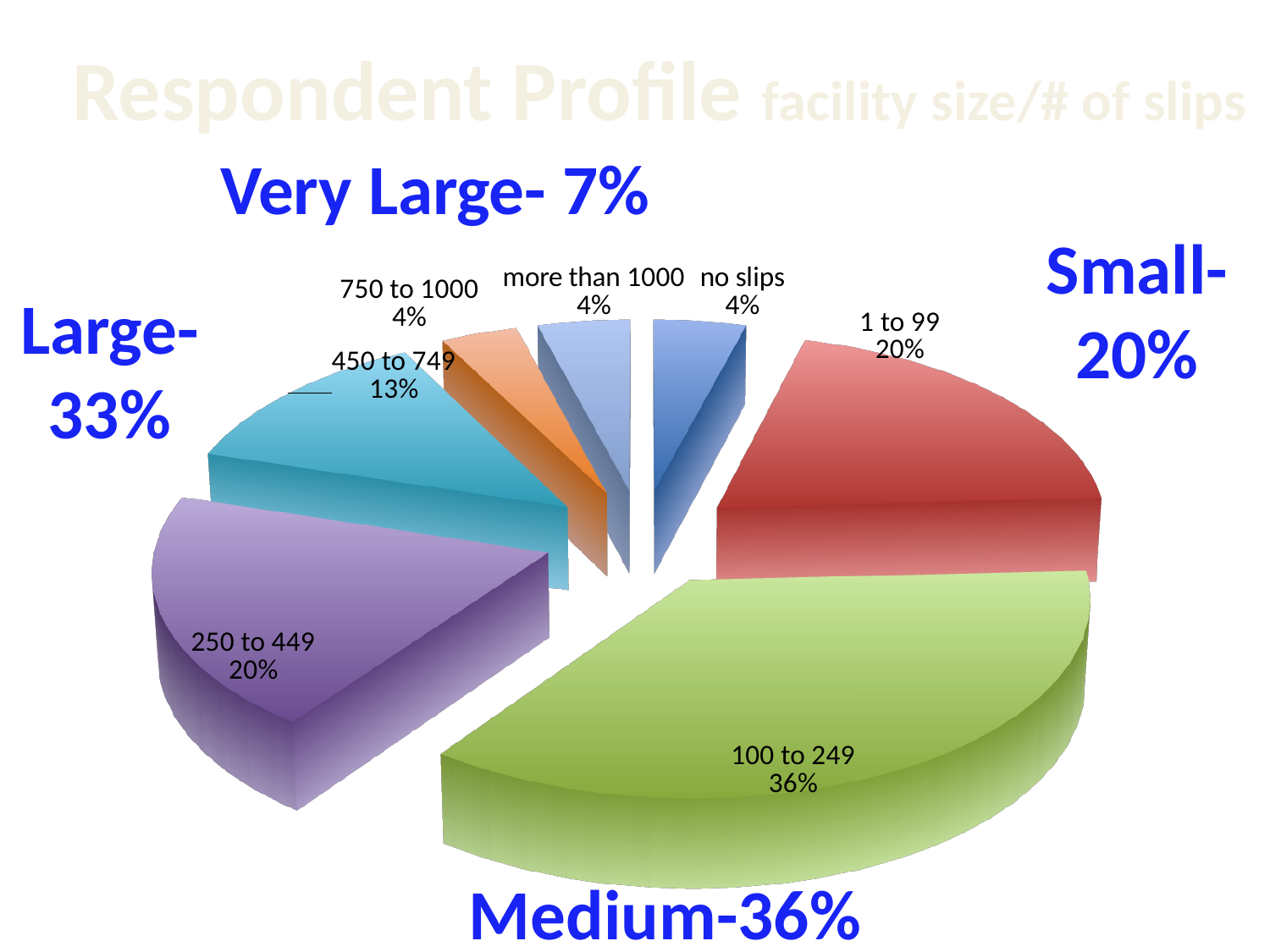
What percentage is annotated for the "Large" group on the slide? 33% How many slices does the pie chart have? 7 What is the difference in percentage points between the "100 to 249" slice and the "1 to 99" slice? 16 Which slice of the pie is the largest? 100 to 249 Which is larger, the "450 to 749" slice or the "750 to 1000" slice? 450 to 749 What percentage is annotated for the "Very Large" group on the slide? 7% What percentage is shown for the "450 to 749" slice? 13% What kind of chart is shown on the slide? Pie chart What share of the pie does the "100 to 249" slice represent? 36% What percentage is shown for the "no slips" slice? 4% What percentage is shown for the "250 to 449" slice? 20% What is the difference in percentage points between the "450 to 749" slice and the "more than 1000" slice? 9